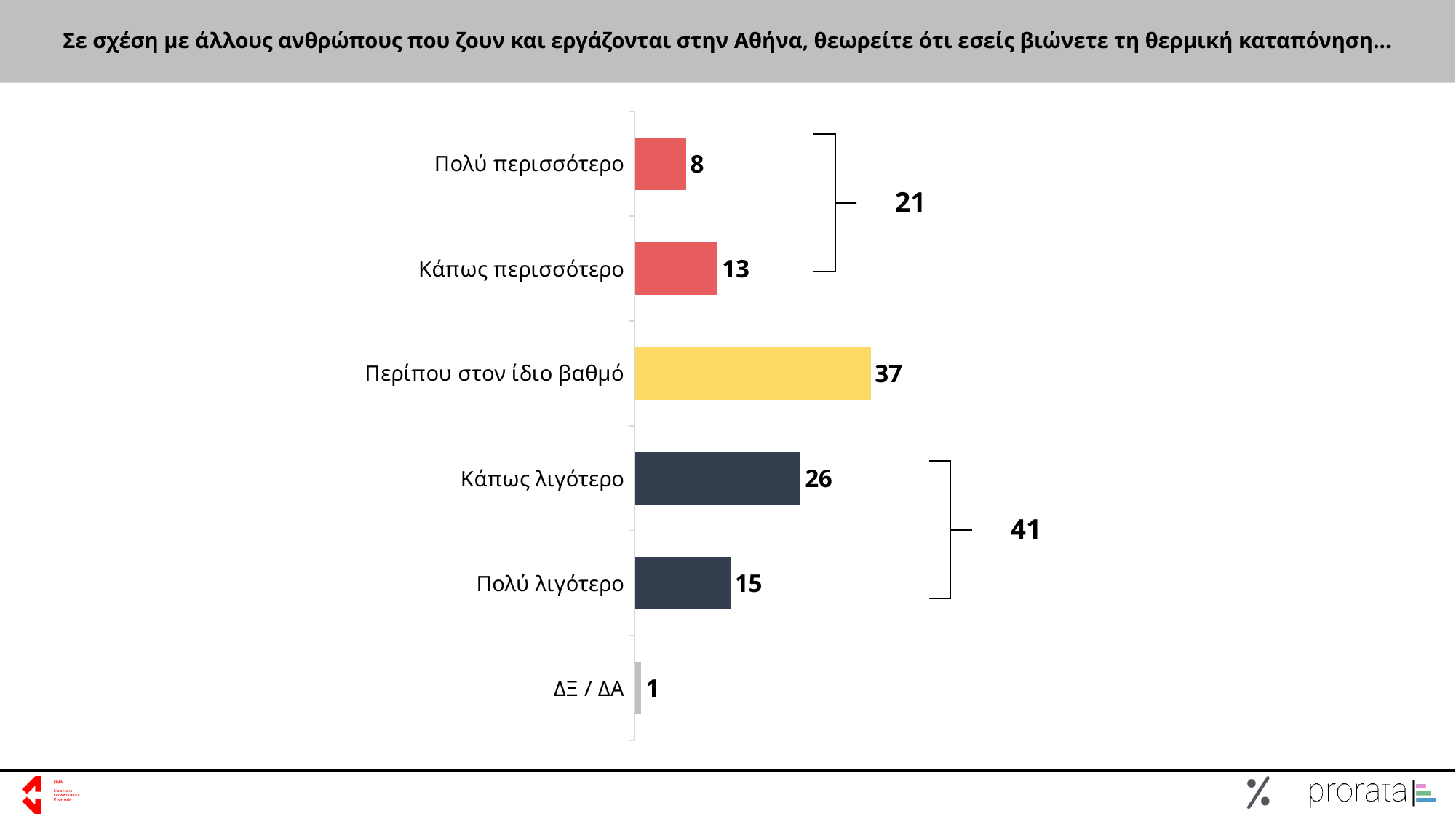
What combined value is shown by the bracket grouping "Κάπως λιγότερο" and "Πολύ λιγότερο"? 41 Which is larger, the value for "Κάπως περισσότερο" or the value for "Πολύ λιγότερο"? Πολύ λιγότερο How many categories are shown in the chart? 6 What is the value for "ΔΞ / ΔΑ"? 1 What combined value is shown by the bracket grouping "Πολύ περισσότερο" and "Κάπως περισσότερο"? 21 What is the value for "Περίπου στον ίδιο βαθμό"? 37 What is the difference between the values for "Κάπως λιγότερο" and "Πολύ λιγότερο"? 11 What is the value for "Πολύ περισσότερο"? 8 What is the value for "Κάπως λιγότερο"? 26 What kind of chart is shown on the slide? Bar chart Which category has the lowest value? ΔΞ / ΔΑ Which category has the highest value? Περίπου στον ίδιο βαθμό